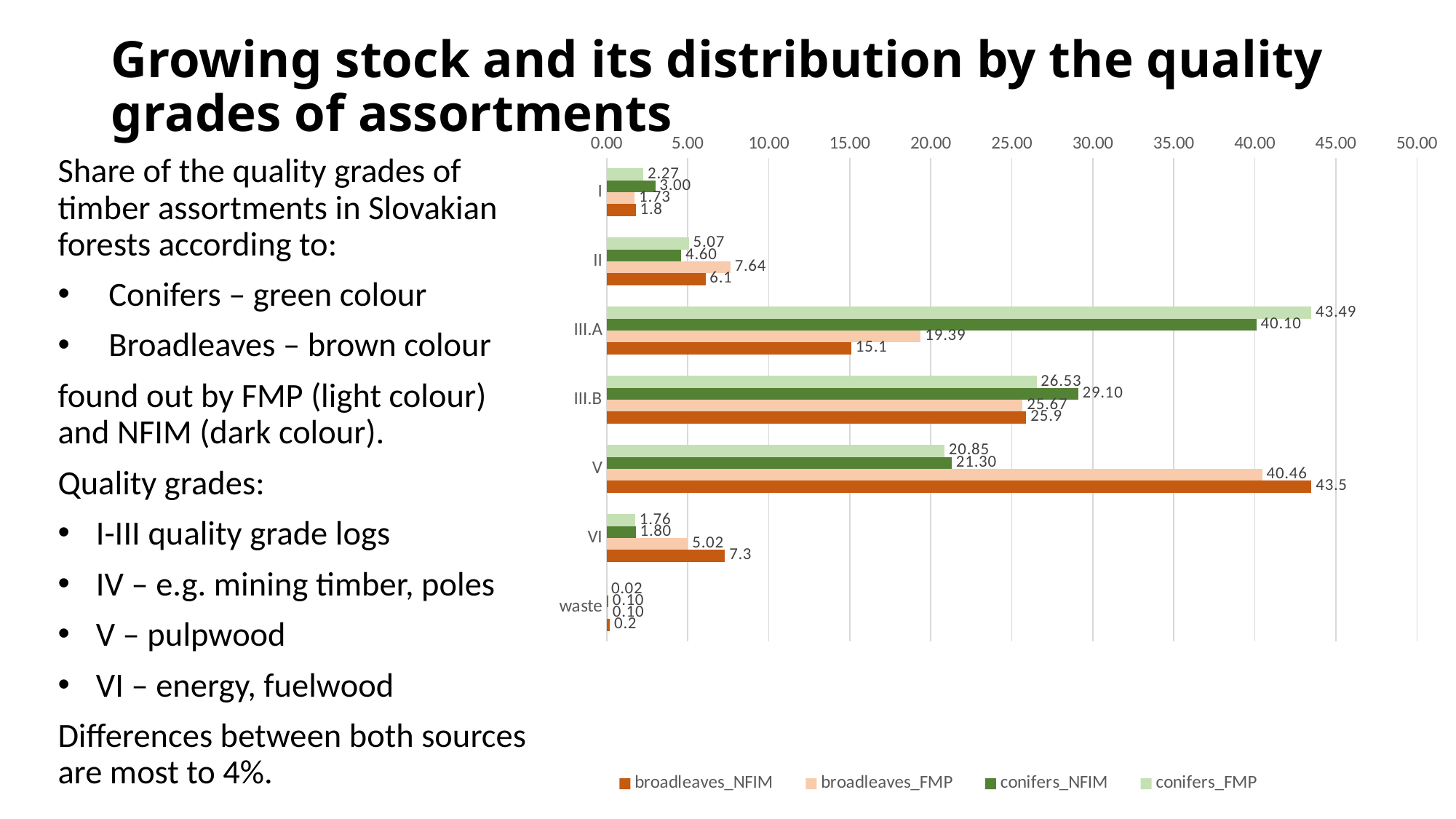
Which quality grade has the highest conifers_NFIM value? III.A What is the value of conifers_FMP for quality grade III.A? 43.49 Which quality grade has the lowest broadleaves_FMP value? waste What type of chart is shown on the slide? bar chart For quality grade V, which is larger: broadleaves_FMP or conifers_FMP? broadleaves_FMP What is the value of broadleaves_FMP for quality grade VI? 5.02 Is the value of conifers_NFIM for quality grade III.B greater or less than 25.00? greater How many quality grade categories are shown on the chart? 7 What is the value of conifers_NFIM for quality grade II? 4.60 What is the difference between the conifers_FMP and conifers_NFIM values for quality grade III.A? 3.39 What is the value of broadleaves_NFIM for quality grade V? 43.5 How many series does the chart legend list? 4